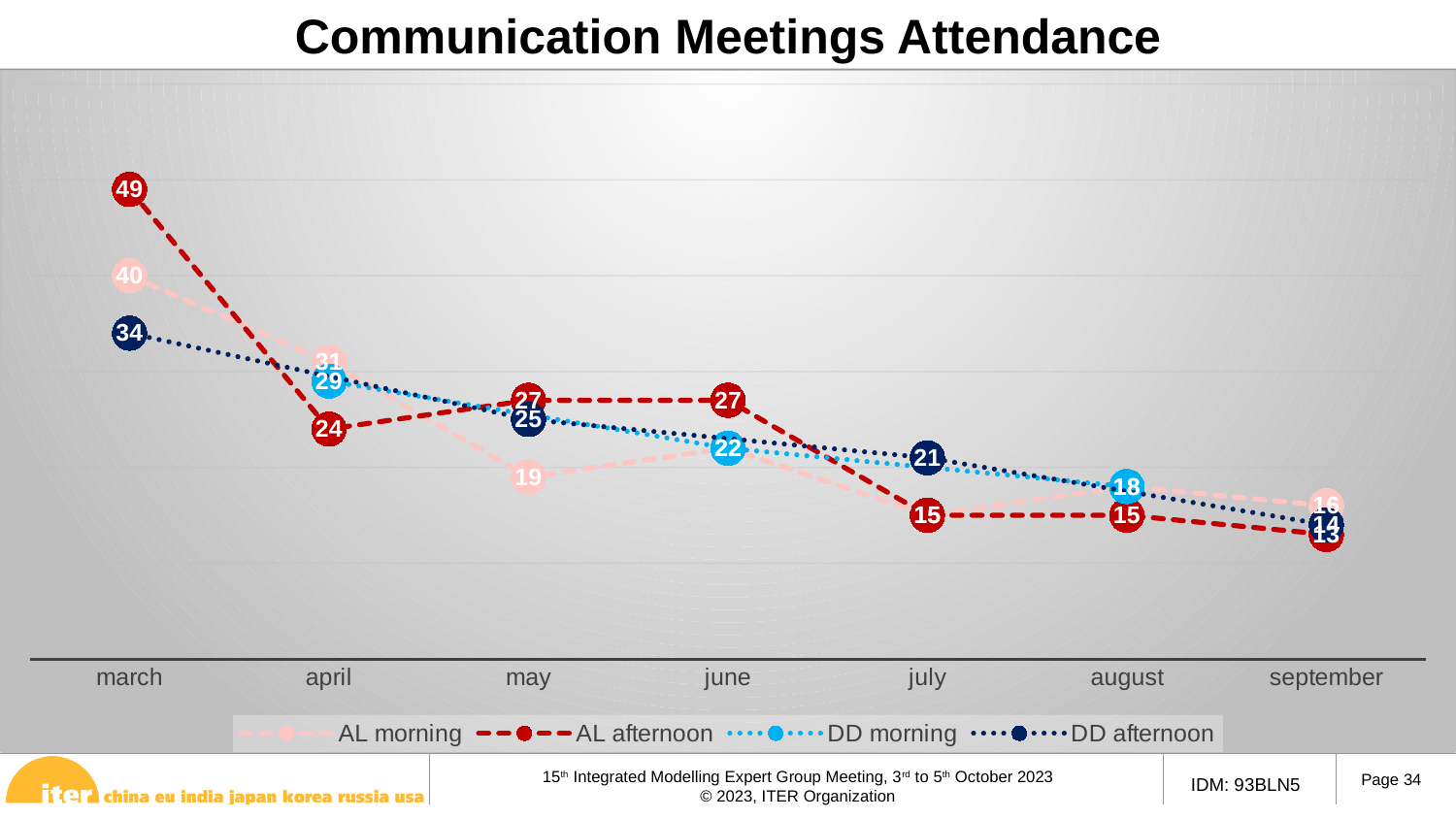
In March, which is larger: AL afternoon or AL morning attendance? AL afternoon What is the AL afternoon attendance in March? 49 What is the AL morning attendance in May? 19 How many series does the legend list? 4 What kind of chart is shown on the slide? line chart How many months are shown on the x axis? 7 What is the AL afternoon attendance in April? 24 In which month does the AL afternoon series reach its highest value? march What is the difference between the AL afternoon attendance in March and in April? 25 What is the AL morning attendance in March? 40 What is the AL afternoon attendance in September? 13 What is the DD afternoon attendance in March? 34